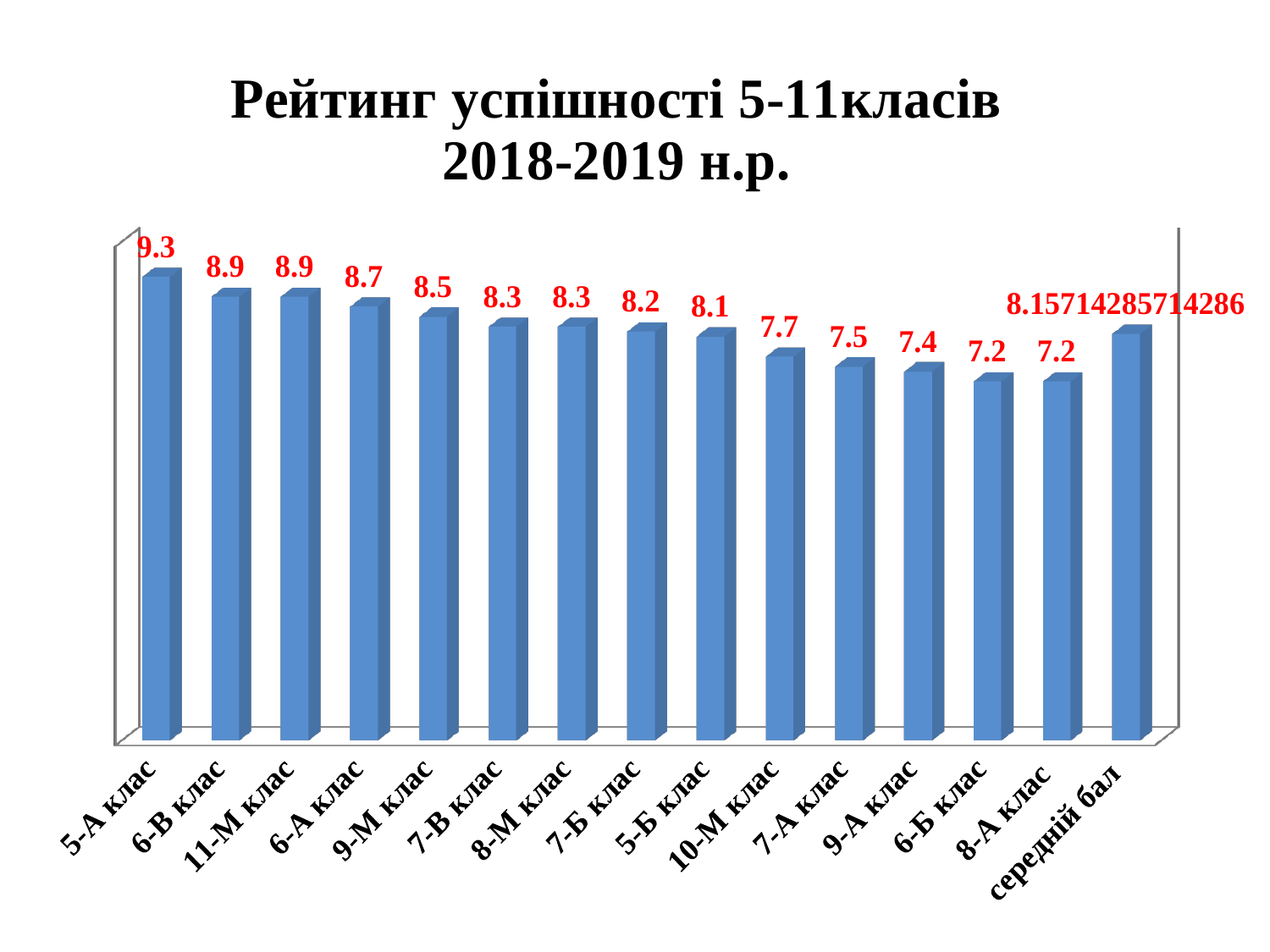
Which class has the highest value? 5-А клас What is the value for 10-М клас? 7.7 Which is larger, the value for 9-М клас or the value for 7-А клас? 9-М клас What is the difference between the values for 5-А клас and 8-А клас? 2.1 What is the difference between the values for 6-А клас and 7-Б клас? 0.5 What kind of chart is shown on the slide? Bar chart What is the value for 5-А клас? 9.3 What is the lowest value shown on the chart? 7.2 What is the title of the chart? Рейтинг успішності 5-11класів 2018-2019 н.р. How many bars are shown on the chart? 15 What is the value for 9-А клас? 7.4 What is the value shown for середній бал? 8.15714285714286